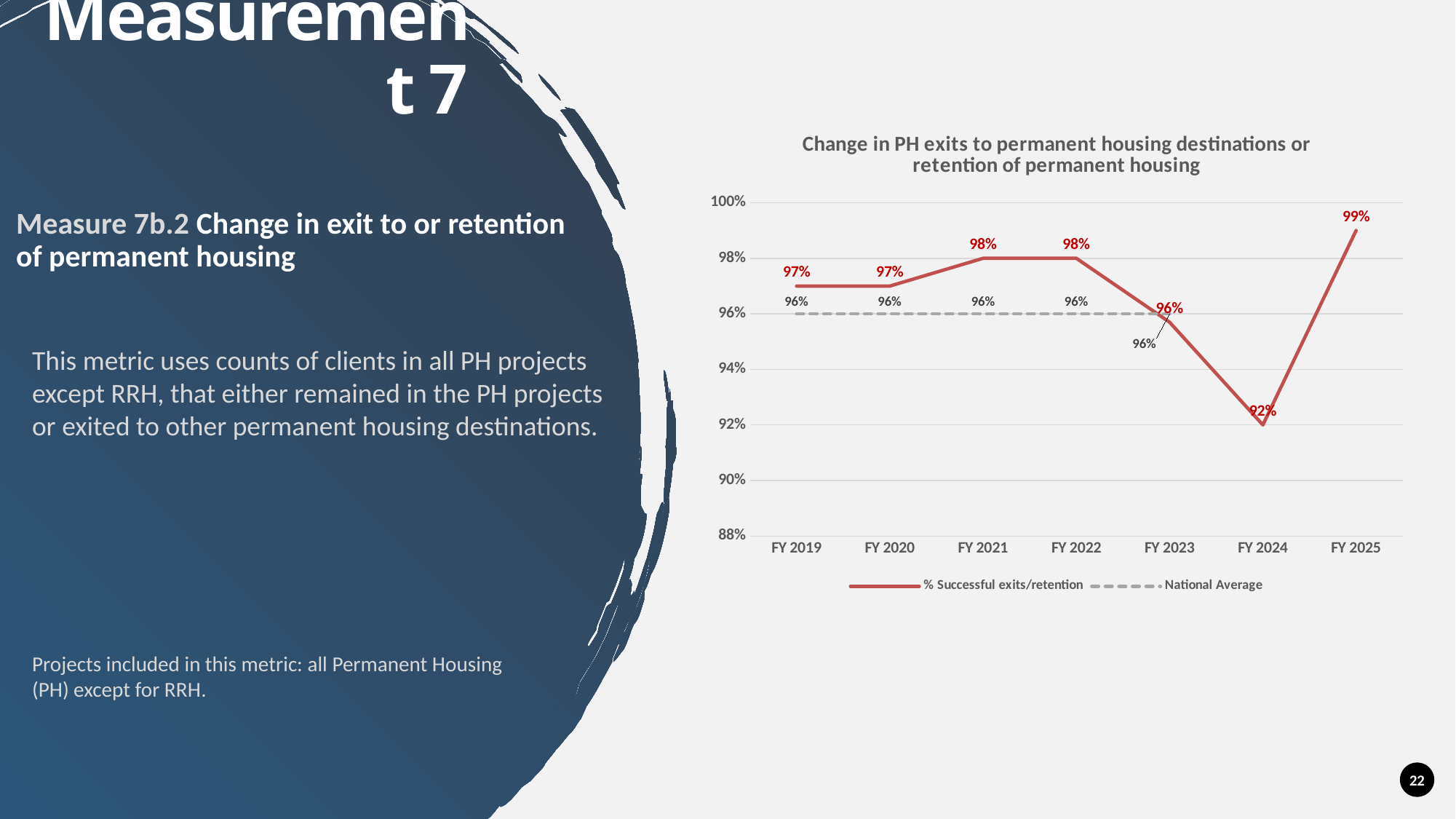
What is the % Successful exits/retention value for FY 2024? 92% What is the % Successful exits/retention value for FY 2025? 99% Which fiscal year has the highest % Successful exits/retention value? FY 2025 How many series does the legend list? 2 How many fiscal years are shown on the x axis? 7 Which fiscal year has the lowest % Successful exits/retention value? FY 2024 What is the National Average value shown for FY 2021? 96% Does the % Successful exits/retention value rise or fall from FY 2022 to FY 2024? Fall What is the title of the chart? Change in PH exits to permanent housing destinations or retention of permanent housing What kind of chart is shown on the slide? Line chart Which is larger: the % Successful exits/retention value for FY 2021 or for FY 2023? FY 2021 What is the difference between the % Successful exits/retention values for FY 2025 and FY 2024? 7%